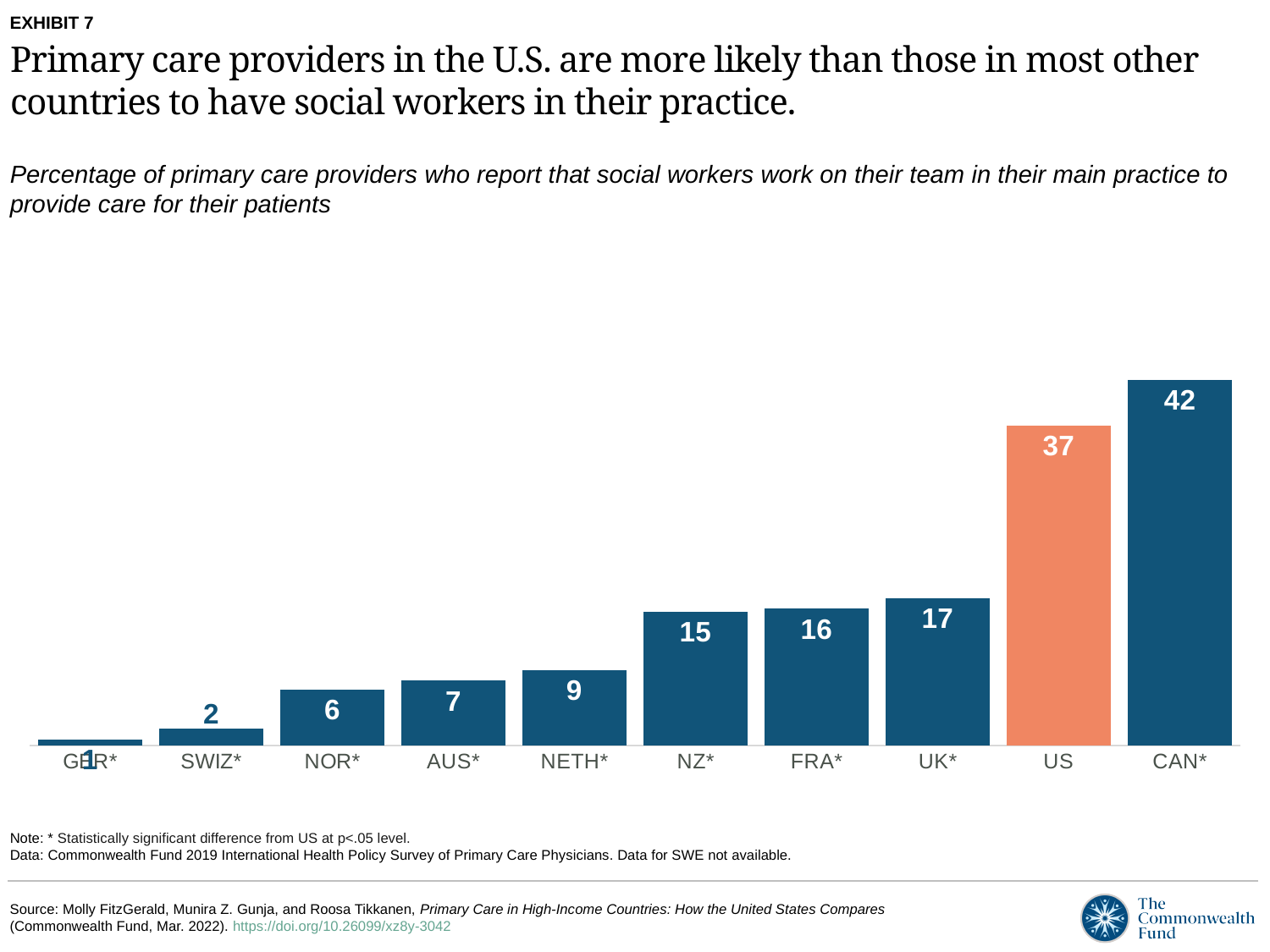
What is the value for SWIZ*? 2 How many countries are shown in the chart? 10 Which is larger, the value for FRA* or the value for NZ*? FRA* What is the difference between the values for CAN* and the US? 5 What is the value for CAN*? 42 What is the difference between the values for UK* and NOR*? 11 What is the value for the US? 37 Do the values rise or fall from left to right along the x axis? Rise Which country has the highest value? CAN* What kind of chart is shown on the slide? Bar chart What is the value for NETH*? 9 Which country has the lowest value? GER*